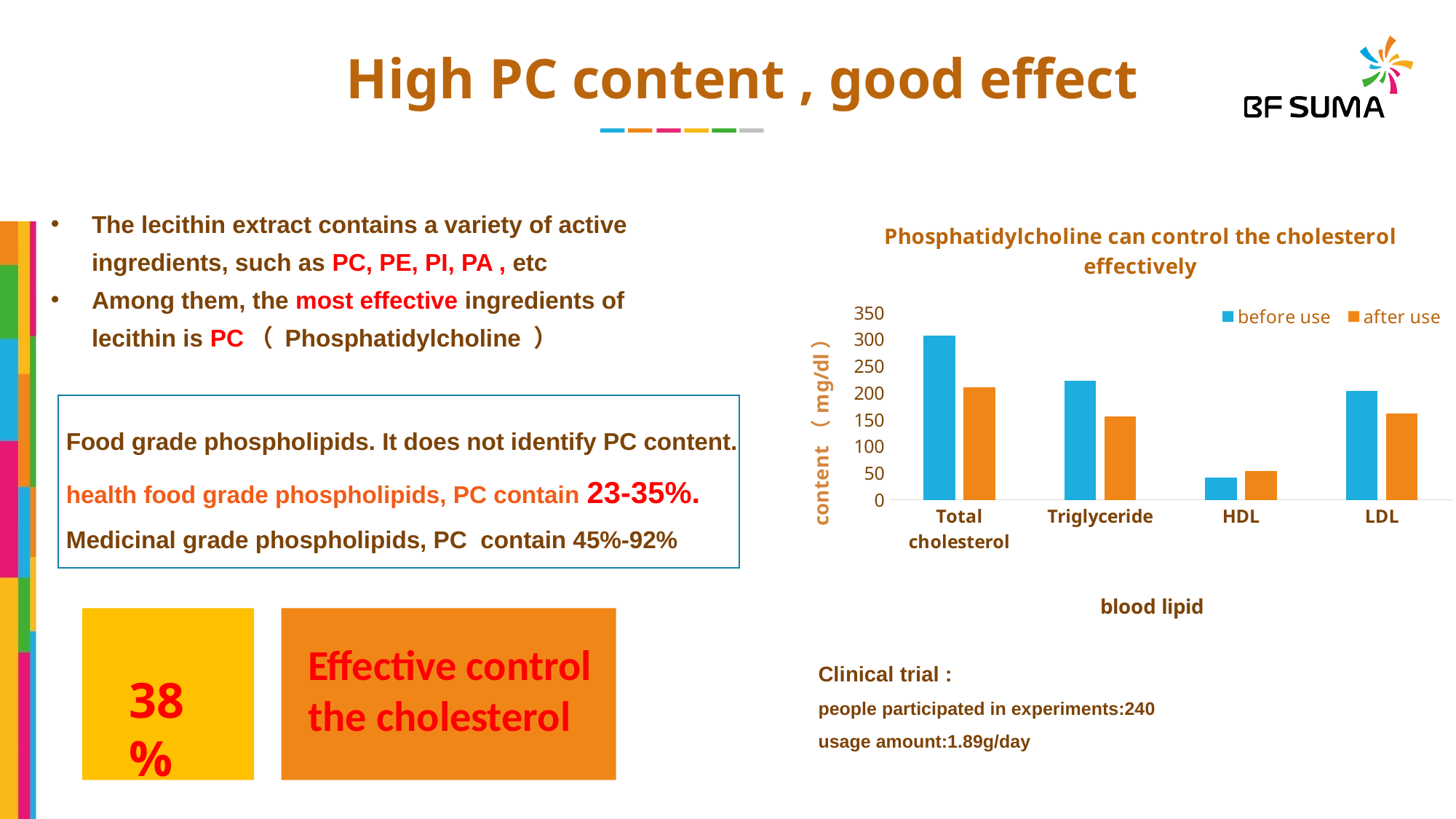
Which category has the highest 'before use' value in the chart? Total cholesterol Is the 'after use' value for Triglyceride greater or less than 200? less For Total cholesterol, which is larger: the 'before use' value or the 'after use' value? before use Is the 'before use' value for LDL greater or less than 150? greater How many blood lipid categories are shown on the x axis of the chart? 4 What is the label of the chart's vertical axis? content (mg/dl) How many series does the chart legend list? 2 Is the 'before use' value for Total cholesterol greater or less than 250? greater Which category has the lowest 'before use' value in the chart? HDL What is the title of the chart? Phosphatidylcholine can control the cholesterol effectively For HDL, which is larger: the 'before use' value or the 'after use' value? after use What kind of chart is shown on the slide? bar chart